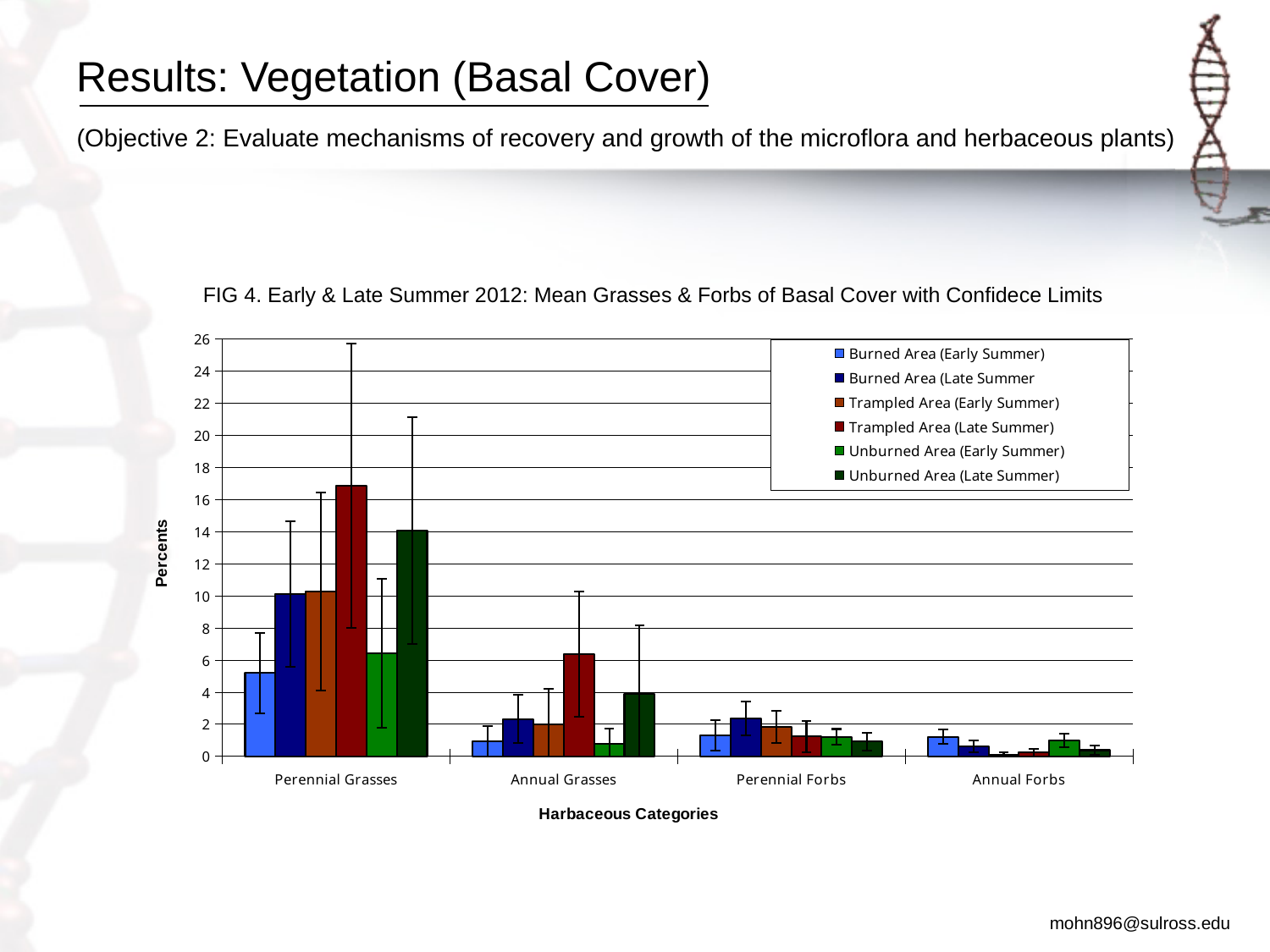
What is the label on the chart's y axis? Percents Is the Burned Area (Early Summer) value for Perennial Grasses greater or less than 6? less For Annual Grasses, which is larger: Unburned Area (Late Summer) or Burned Area (Late Summer)? Unburned Area (Late Summer) How many herbaceous categories are shown on the x axis of the chart? 4 Is the Trampled Area (Late Summer) value for Perennial Grasses greater or less than 16? greater For Perennial Grasses, which is larger: Unburned Area (Late Summer) or Burned Area (Late Summer)? Unburned Area (Late Summer) How many series does the chart's legend list? 6 What kind of chart is shown in FIG 4? Bar chart Is the Unburned Area (Early Summer) value for Perennial Grasses greater or less than 8? less Within the Perennial Grasses category, which series has the tallest bar? Trampled Area (Late Summer) Within the Annual Grasses category, which series has the tallest bar? Trampled Area (Late Summer)